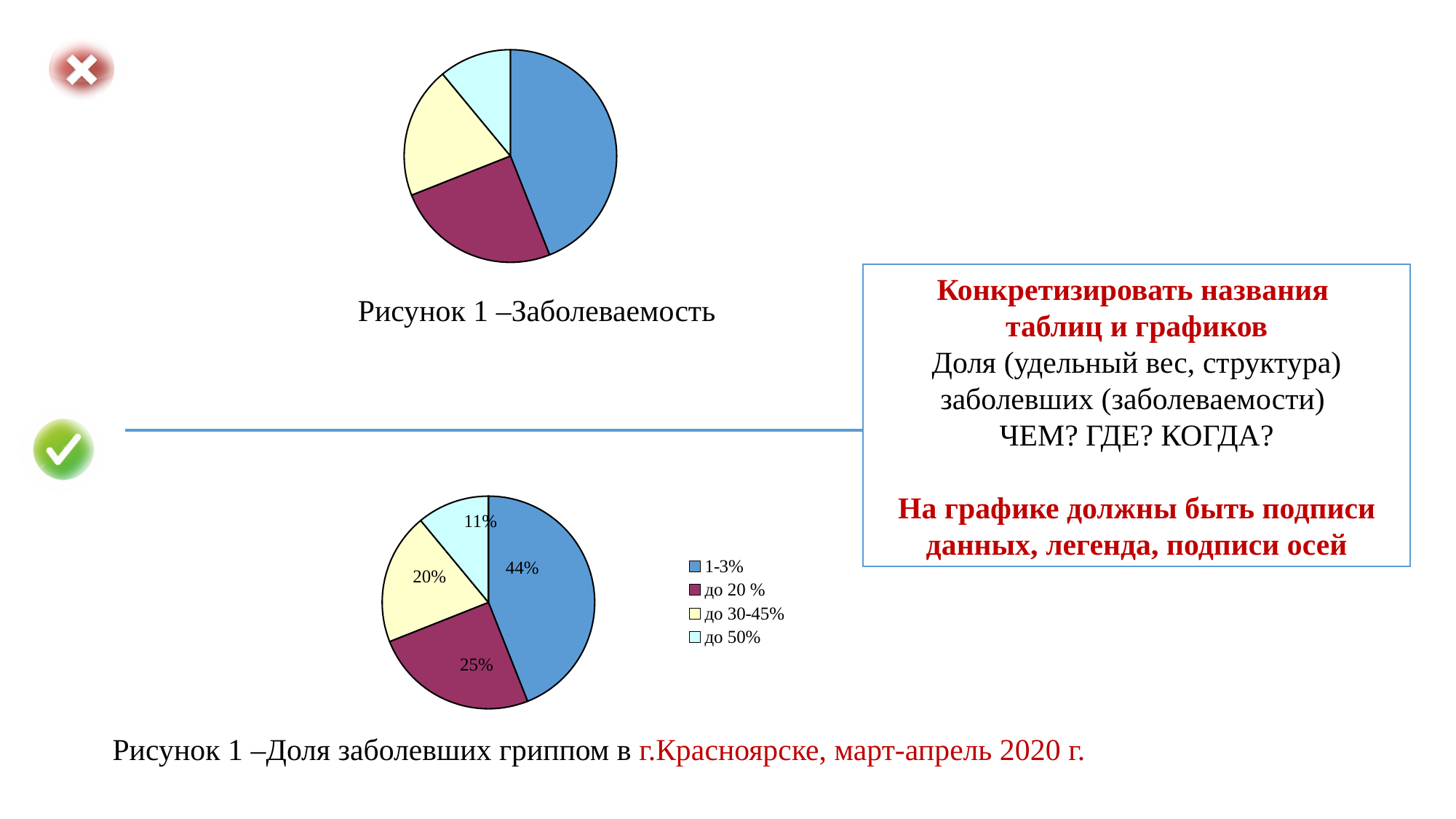
On the bottom chart, what share is shown for the category "до 30-45%"? 20% On the bottom chart (Доля заболевших гриппом в г.Красноярске), what share is shown for the category "1-3%"? 44% On the bottom chart, which category has the largest slice? 1-3% On the bottom chart, what share is shown for the category "до 20 %"? 25% On the bottom chart, what share is shown for the category "до 50%"? 11% On the bottom chart, which category has the smallest slice? до 50% What is the caption of the bottom chart? Рисунок 1 – Доля заболевших гриппом в г.Красноярске, март-апрель 2020 г. On the bottom chart, which is larger: the share for "до 30-45%" or the share for "до 50%"? до 30-45% How many slices does the top chart have? 4 What kind of chart is the top chart (Рисунок 1 – Заболеваемость)? Pie chart How many entries does the legend of the bottom chart list? 4 On the bottom chart, what is the difference between the shares for "1-3%" and "до 20 %"? 19%